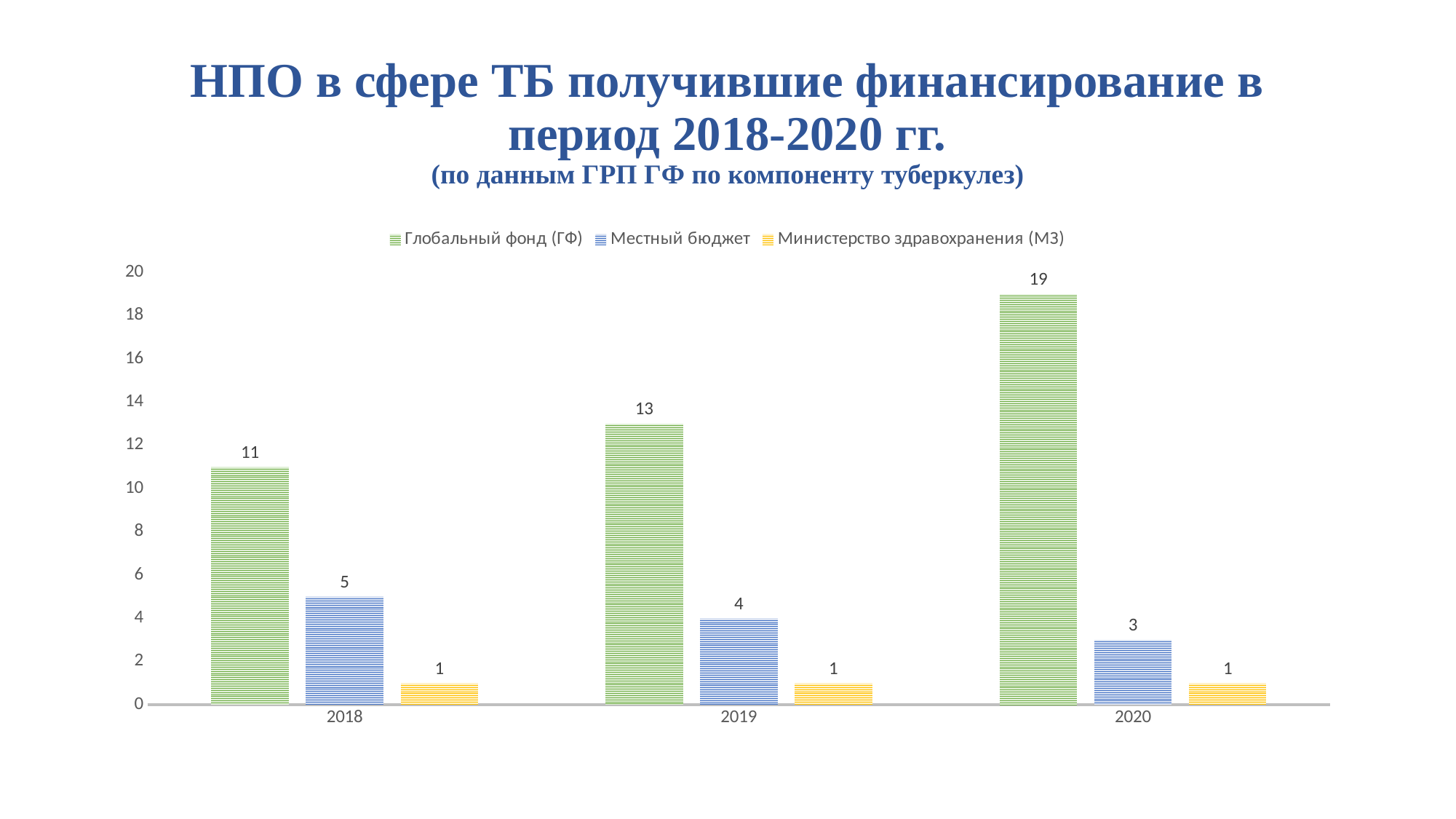
What kind of chart is shown on the slide? Bar chart What is the difference between the Глобальный фонд (ГФ) values for 2020 and 2018? 8 How many series does the legend list? 3 What is the value for Глобальный фонд (ГФ) in 2020? 19 What is the value for Местный бюджет in 2018? 5 Does the value for Глобальный фонд (ГФ) rise or fall from 2018 to 2020? Rise Which is larger in 2019: Глобальный фонд (ГФ) or Местный бюджет? Глобальный фонд (ГФ) In which year is the value for Глобальный фонд (ГФ) highest? 2020 In which year is the value for Местный бюджет lowest? 2020 What is the value for Министерство здравоохранения (МЗ) in 2019? 1 How many years are shown on the x axis? 3 Is the value for Глобальный фонд (ГФ) in 2019 greater or less than 10? greater